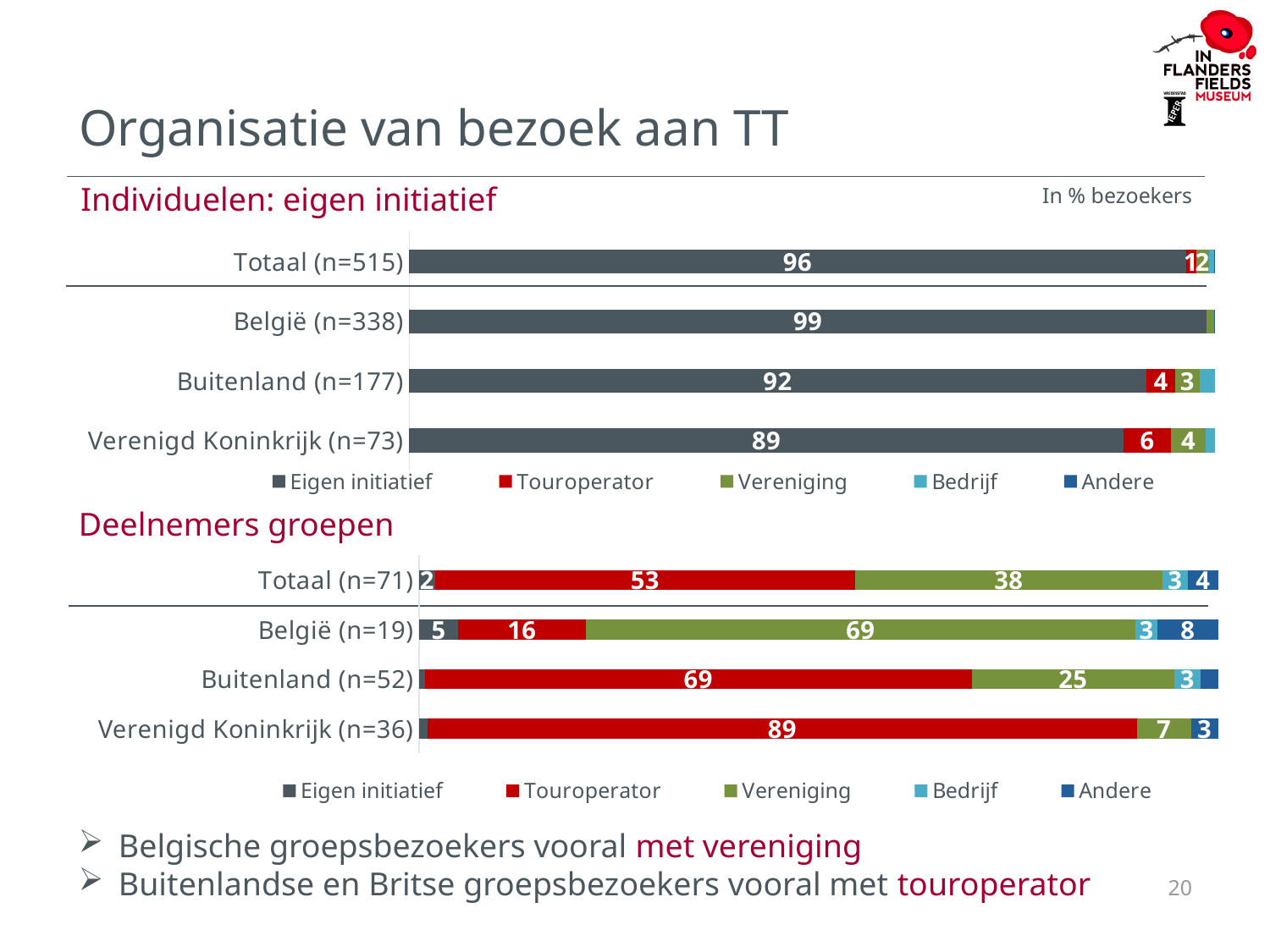
In the 'Deelnemers groepen' chart, what is the difference between the Touroperator values for Buitenland (n=52) and België (n=19)? 53 In the 'Deelnemers groepen' chart, what is the Vereniging value for België (n=19)? 69 How many series does the legend of the 'Deelnemers groepen' chart list? 5 In the 'Individuelen: eigen initiatief' chart, which category has the lowest Eigen initiatief value? Verenigd Koninkrijk (n=73) In the 'Deelnemers groepen' chart, which category has the highest Touroperator value? Verenigd Koninkrijk (n=36) In the 'Individuelen: eigen initiatief' chart, what is the Eigen initiatief value for België (n=338)? 99 In the 'Individuelen: eigen initiatief' chart, what is the Eigen initiatief value for Totaal (n=515)? 96 In the 'Individuelen: eigen initiatief' chart, what is the difference between the Eigen initiatief values for België (n=338) and Buitenland (n=177)? 7 What type of chart is the 'Individuelen: eigen initiatief' chart? Stacked bar chart In the 'Deelnemers groepen' chart, what is the Touroperator value for Verenigd Koninkrijk (n=36)? 89 In the 'Deelnemers groepen' chart, which is larger for Totaal (n=71): the Touroperator value or the Vereniging value? Touroperator In the 'Individuelen: eigen initiatief' chart, what is the Touroperator value for Verenigd Koninkrijk (n=73)? 6